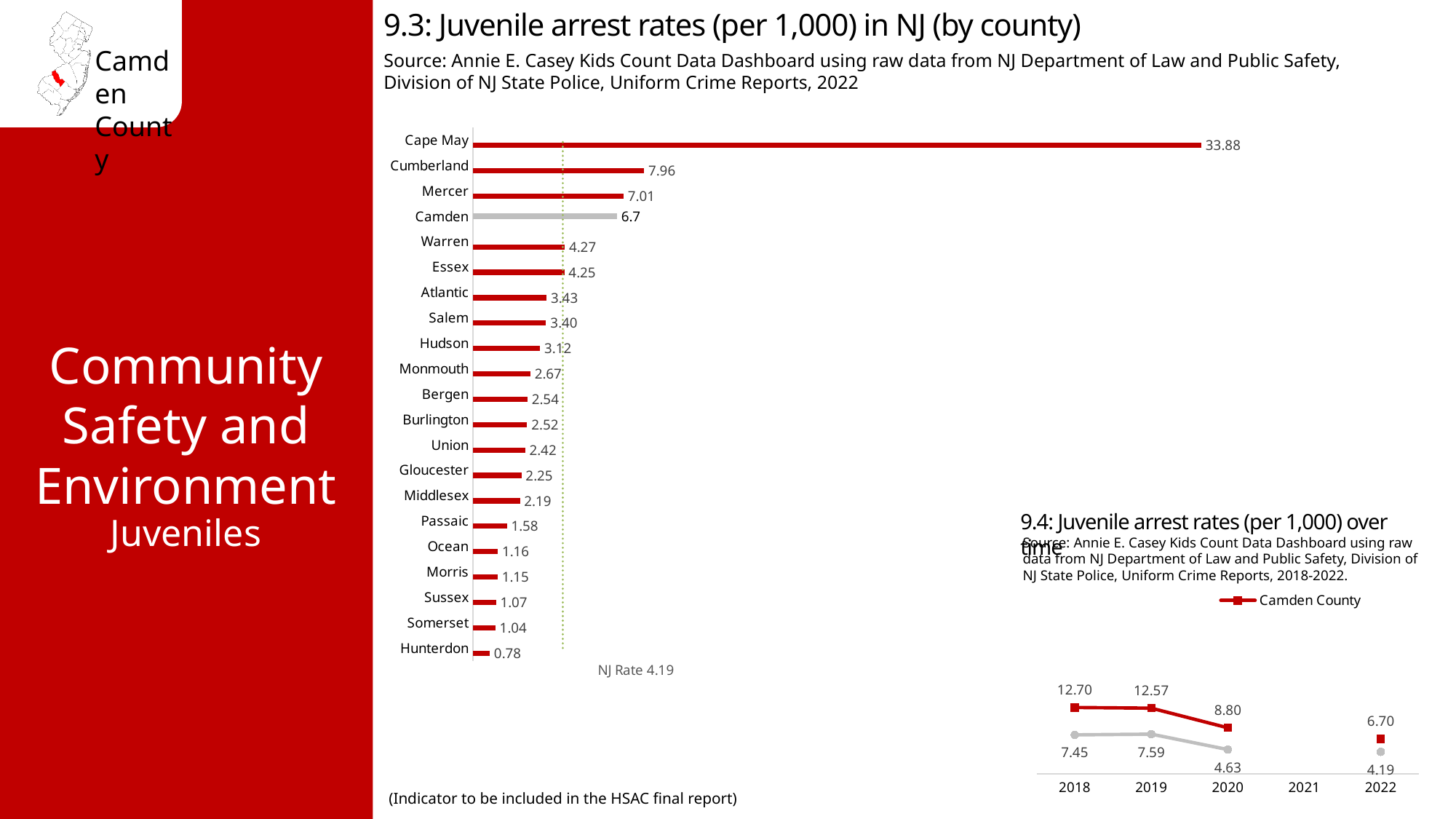
In the chart '9.4: Juvenile arrest rates (per 1,000) over time', what is the Camden County value for 2022? 6.70 In the chart '9.3: Juvenile arrest rates (per 1,000) in NJ (by county)', which county has the highest rate? Cape May What kind of chart is '9.3: Juvenile arrest rates (per 1,000) in NJ (by county)'? Bar chart In the chart '9.3: Juvenile arrest rates (per 1,000) in NJ (by county)', which county has the lowest rate? Hunterdon In the chart '9.3: Juvenile arrest rates (per 1,000) in NJ (by county)', what is the value for Cape May? 33.88 In the chart '9.4: Juvenile arrest rates (per 1,000) over time', does the Camden County rate rise or fall from 2018 to 2022? Fall In the chart '9.3: Juvenile arrest rates (per 1,000) in NJ (by county)', what NJ rate is marked by the dotted line? 4.19 In the chart '9.4: Juvenile arrest rates (per 1,000) over time', what is the Camden County value for 2018? 12.70 In the chart '9.3: Juvenile arrest rates (per 1,000) in NJ (by county)', how many counties are shown? 21 In the chart '9.4: Juvenile arrest rates (per 1,000) over time', how many series does the legend list? 1 In the chart '9.3: Juvenile arrest rates (per 1,000) in NJ (by county)', what is the difference between Cumberland and Mercer? 0.95 In the chart '9.3: Juvenile arrest rates (per 1,000) in NJ (by county)', what is the value for Camden? 6.7